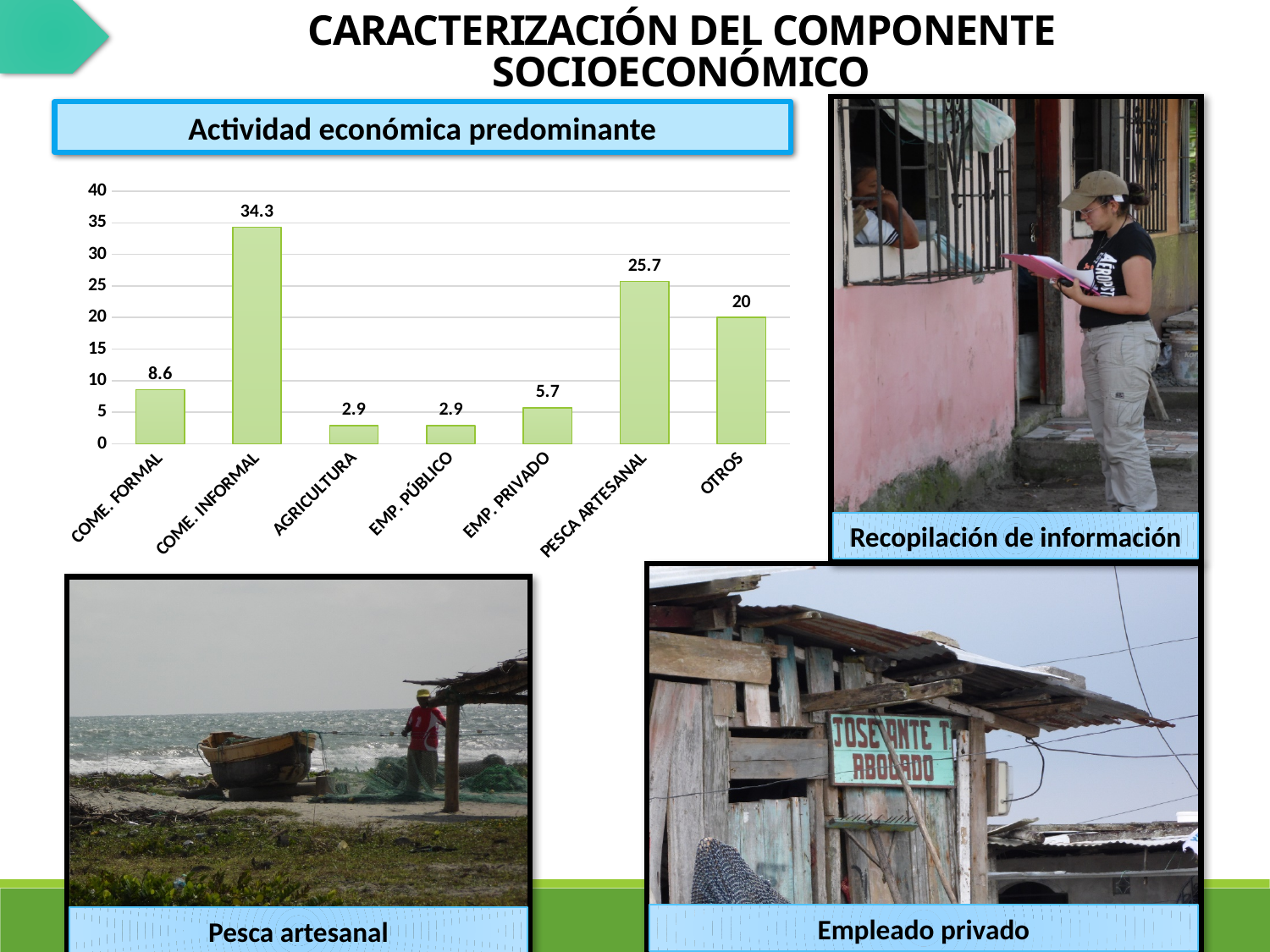
How many categories are shown on the x axis? 7 What is the value for OTROS? 20 What is the value for PESCA ARTESANAL? 25.7 What is the difference between COME. INFORMAL and PESCA ARTESANAL? 8.6 What is the value for COME. INFORMAL? 34.3 Which category has the highest value? COME. INFORMAL What is the difference between COME. FORMAL and EMP. PRIVADO? 2.9 What is the value for COME. FORMAL? 8.6 What is the title of the chart? Actividad económica predominante Which is larger, EMP. PRIVADO or COME. FORMAL? COME. FORMAL What kind of chart is shown on the slide? bar chart Is the value for OTROS greater or less than 25? less